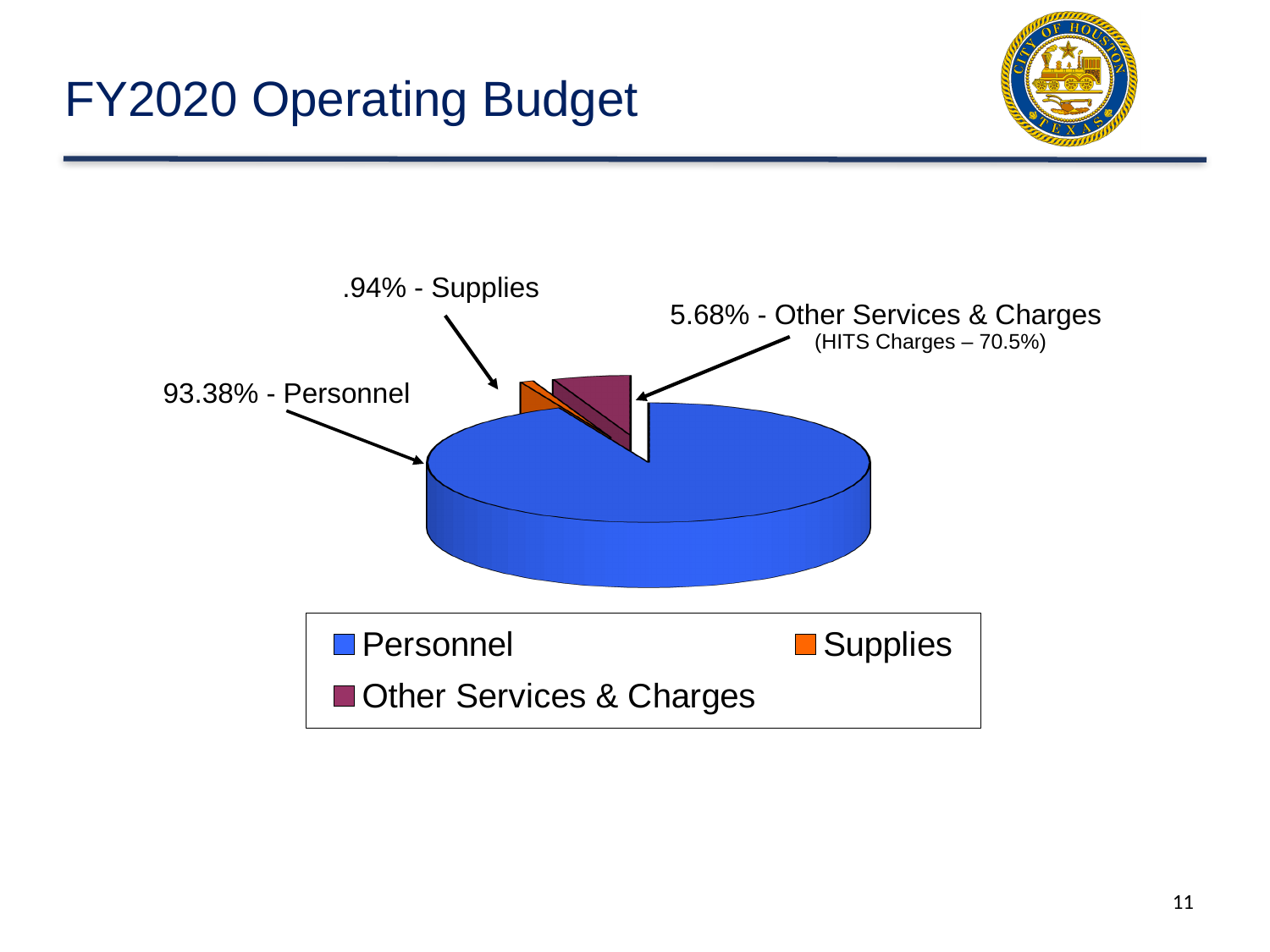
What colour represents Personnel in the pie chart? Blue What percentage of Other Services & Charges is attributed to HITS Charges? 70.5% What is the title of the slide containing the pie chart? FY2020 Operating Budget How many categories does the pie chart show? 3 Which category has the smallest share of the FY2020 Operating Budget? Supplies What kind of chart is shown on the slide? Pie chart What share of the FY2020 Operating Budget is Personnel? 93.38% Which is larger, the share for Supplies or the share for Other Services & Charges? Other Services & Charges What share of the FY2020 Operating Budget is Supplies? .94% Which category has the largest share of the FY2020 Operating Budget? Personnel What share of the FY2020 Operating Budget is Other Services & Charges? 5.68% What is the difference in percentage points between the Personnel share and the Other Services & Charges share? 87.70%